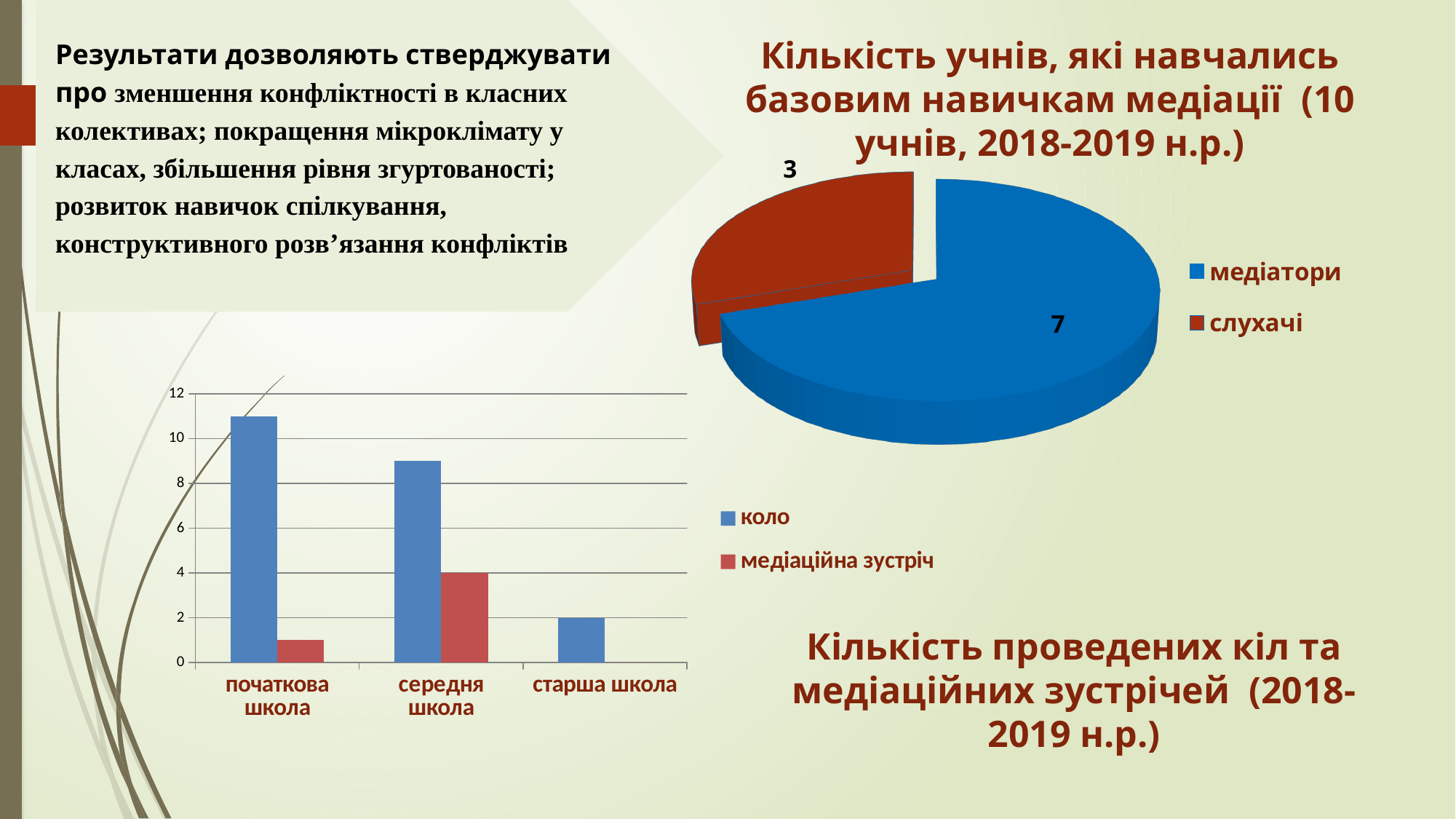
On the pie chart 'Кількість учнів, які навчались базовим навичкам медіації', what is the value for слухачі? 3 How many entries does the legend of the pie chart 'Кількість учнів, які навчались базовим навичкам медіації' list? 2 On the pie chart 'Кількість учнів, які навчались базовим навичкам медіації', what is the difference between медіатори and слухачі? 4 On the bar chart 'Кількість проведених кіл та медіаційних зустрічей', which category has the highest value for коло? початкова школа On the pie chart 'Кількість учнів, які навчались базовим навичкам медіації', what is the value for медіатори? 7 What kind of chart is 'Кількість проведених кіл та медіаційних зустрічей (2018-2019 н.р.)'? bar chart On the bar chart 'Кількість проведених кіл та медіаційних зустрічей', is the value of коло for початкова школа greater or less than 10? greater On the bar chart 'Кількість проведених кіл та медіаційних зустрічей', what is the value of медіаційна зустріч for середня школа? 4 On the bar chart 'Кількість проведених кіл та медіаційних зустрічей', what is the value of коло for старша школа? 2 On the pie chart 'Кількість учнів, які навчались базовим навичкам медіації', what share of the total do медіатори make up? 70% How many categories are shown on the x axis of the bar chart 'Кількість проведених кіл та медіаційних зустрічей'? 3 On the pie chart 'Кількість учнів, які навчались базовим навичкам медіації', which slice is the largest? медіатори